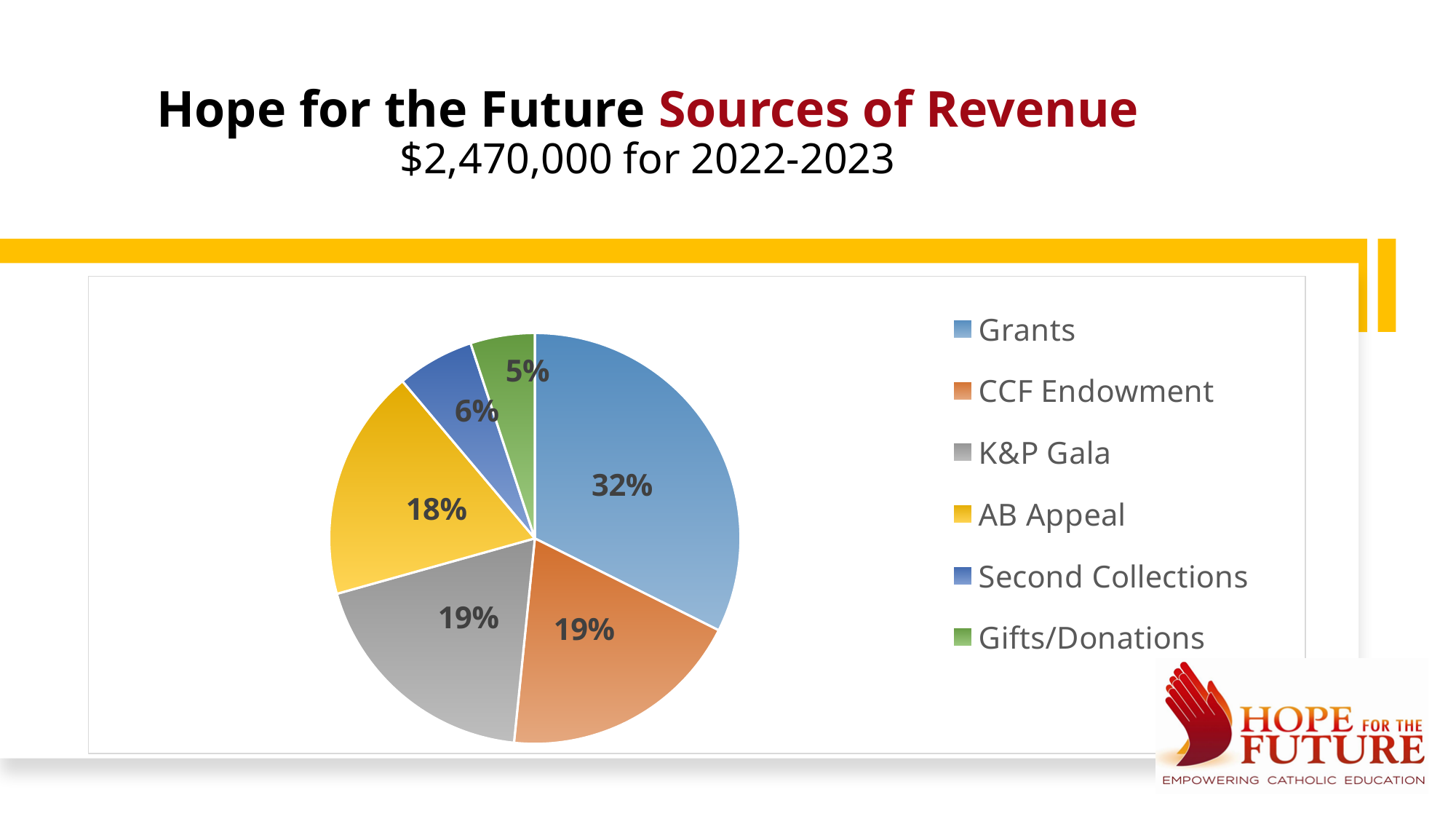
What kind of chart is shown on the slide? pie chart Which is larger, the share for K&P Gala or the share for Second Collections? K&P Gala What share of revenue comes from Gifts/Donations? 5% How many sources of revenue are shown in the pie chart? 6 Which source of revenue has the largest share? Grants What share of revenue comes from AB Appeal? 18% What share of revenue comes from Grants? 32% What share of revenue comes from Second Collections? 6% What is the difference in percentage points between Grants and AB Appeal? 14 What total revenue amount is stated in the slide subtitle for 2022-2023? $2,470,000 Which source of revenue has the smallest share? Gifts/Donations What share of revenue comes from CCF Endowment? 19%